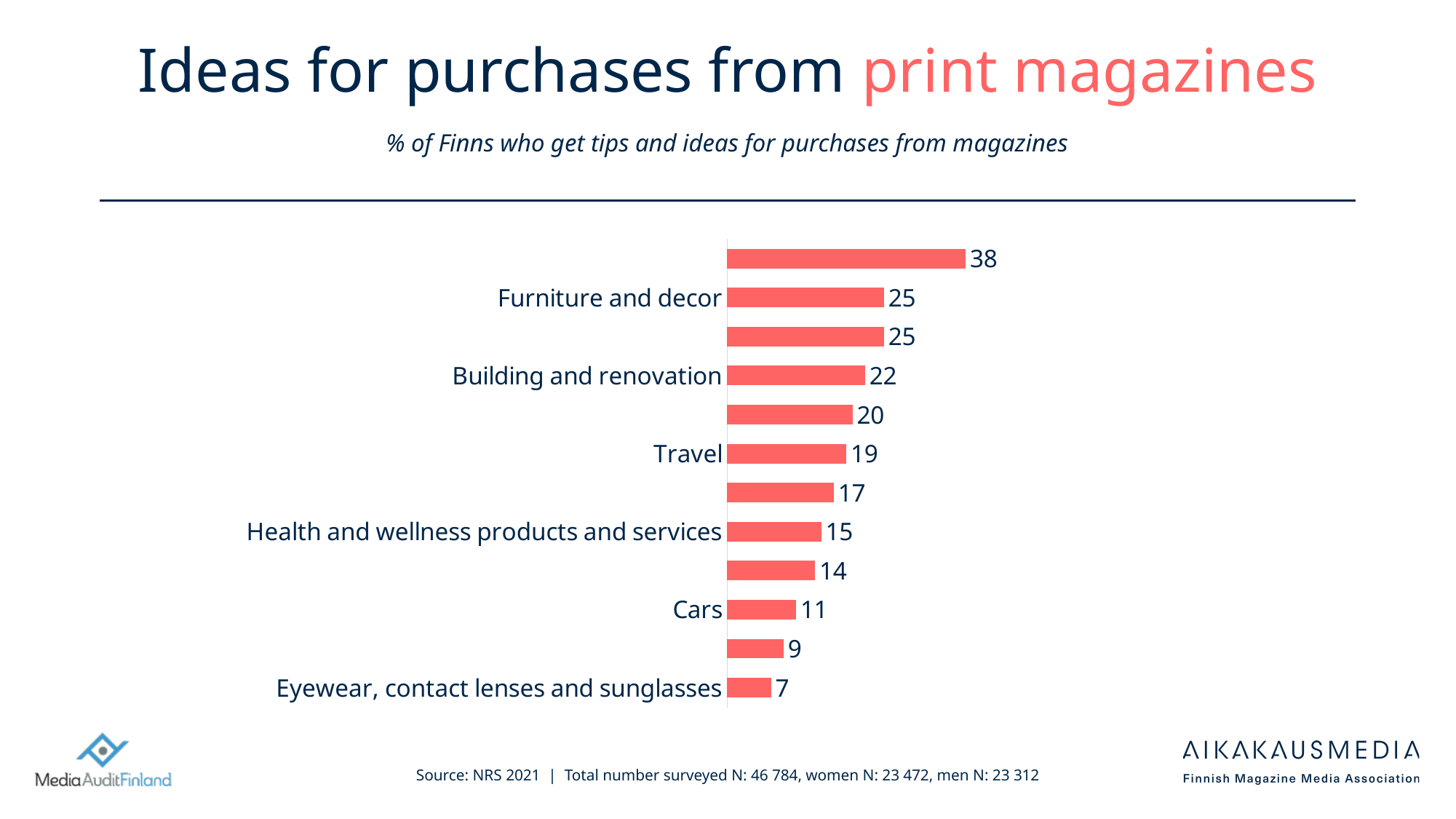
What is the largest value shown on the chart? 38 How many bars are plotted on the chart? 12 What is the value for Health and wellness products and services? 15 What is the value for Building and renovation? 22 What kind of chart is shown on the slide? bar chart What is the value for Furniture and decor? 25 Which labelled category has the lowest value? Eyewear, contact lenses and sunglasses What is the value for Cars? 11 What is the value for Eyewear, contact lenses and sunglasses? 7 What is the value for Travel? 19 Which is larger, the value for Travel or the value for Building and renovation? Building and renovation What is the difference between the values for Furniture and decor and Cars? 14